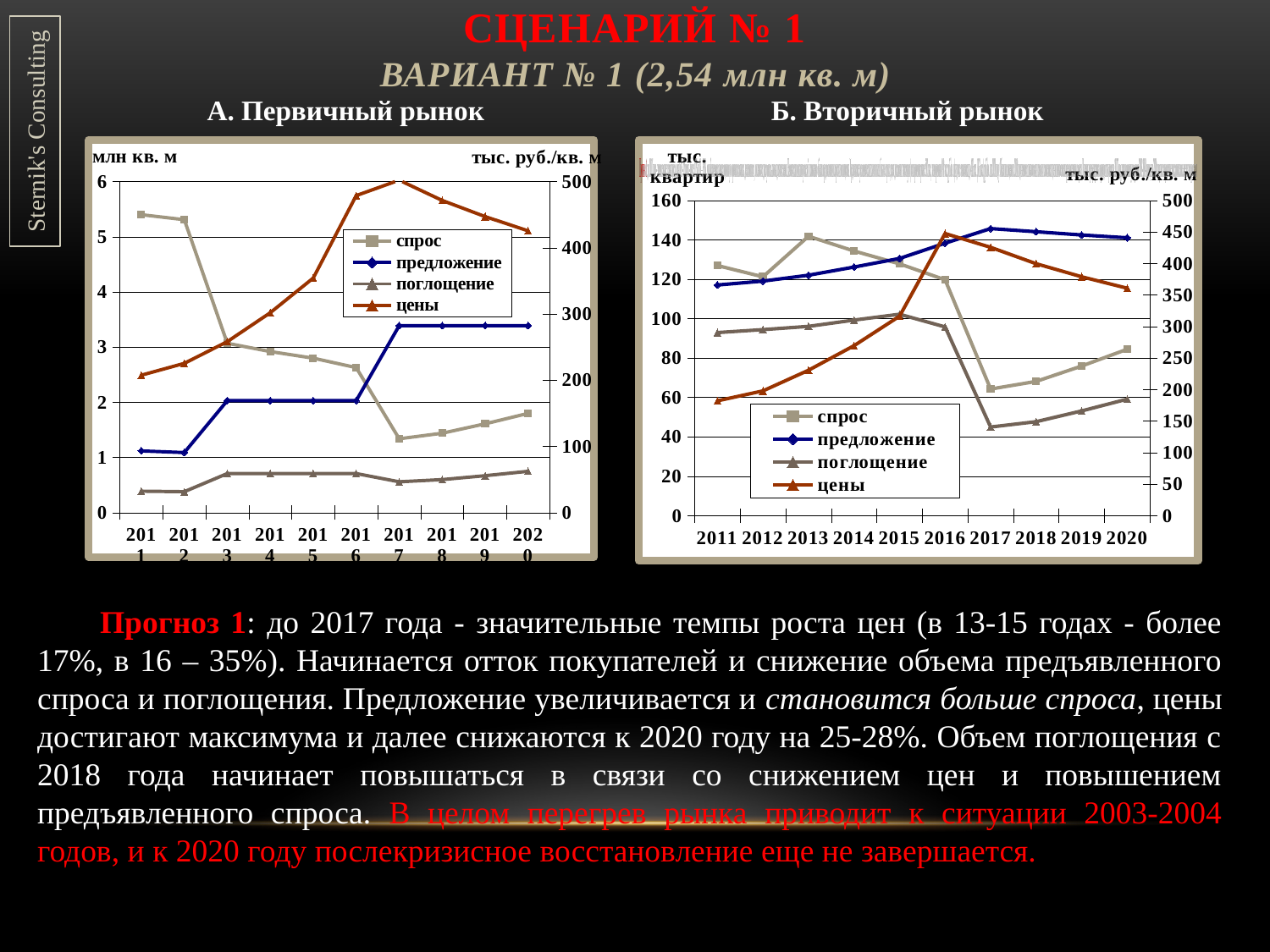
In the left chart 'А. Первичный рынок', is the value of 'спрос' in 2011 greater or less than 5? greater In the right chart 'Б. Вторичный рынок', how many years are plotted along the x axis? 10 In the right chart 'Б. Вторичный рынок', do the 'цены' values rise or fall from 2011 to 2016? rise What kind of chart is the left chart titled 'А. Первичный рынок'? line chart In the left chart 'А. Первичный рынок', is the value of 'предложение' in 2020 greater or less than 3? greater In the right chart 'Б. Вторичный рынок', is the value of 'предложение' in 2017 greater or less than 140? greater In the left chart 'А. Первичный рынок', which is larger in 2020: 'спрос' or 'предложение'? предложение In the left chart 'А. Первичный рынок', how many series does the legend list? 4 In the right chart 'Б. Вторичный рынок', in which year does the 'спрос' series reach its highest value? 2013 In the left chart 'А. Первичный рынок', in which year does the 'цены' series reach its highest value? 2017 In the right chart 'Б. Вторичный рынок', which is larger in 2017: 'спрос' or 'поглощение'? спрос In the right chart 'Б. Вторичный рынок', what is the label of the right-hand vertical axis? тыс. руб./кв. м